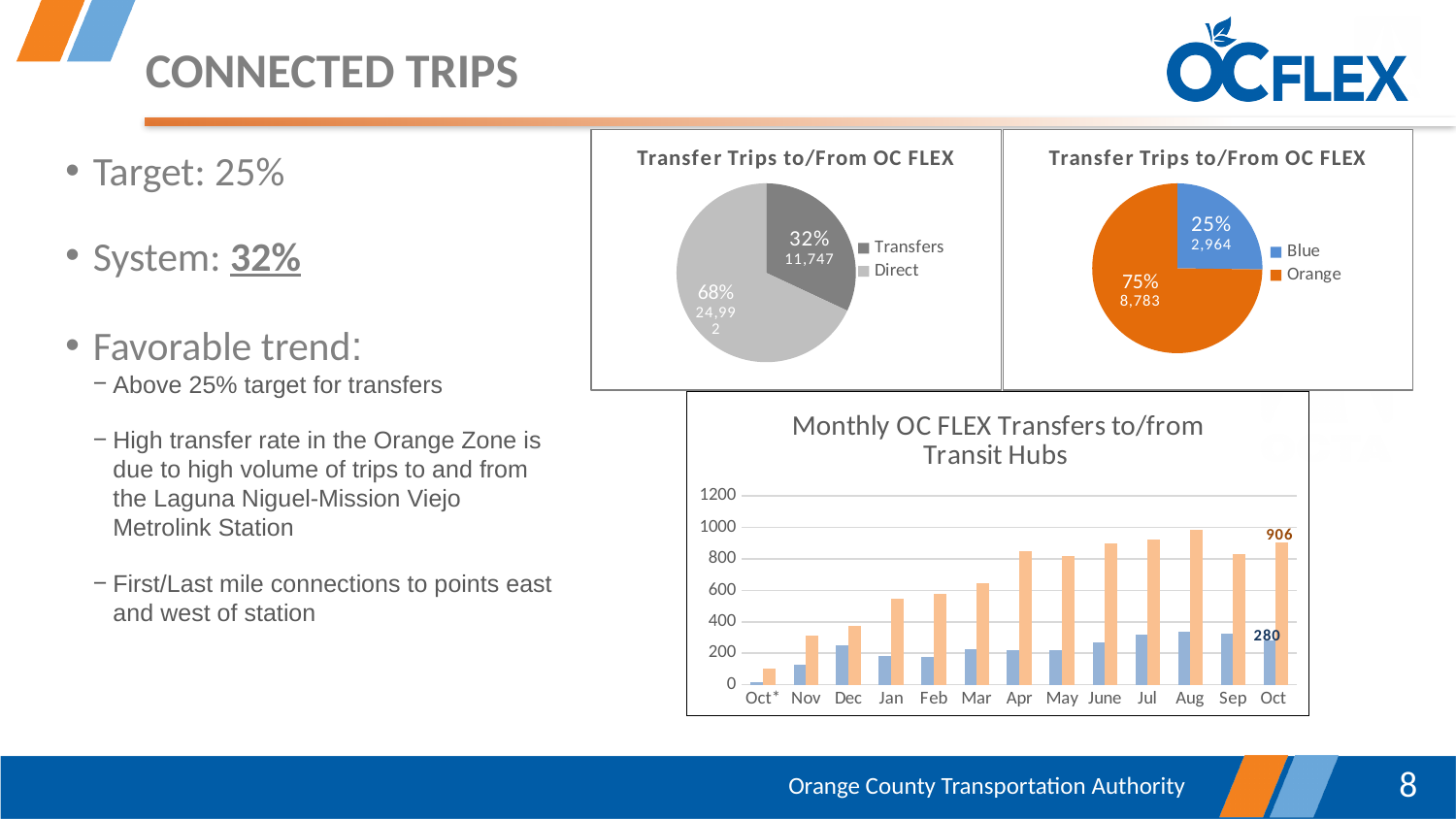
In the chart 'Monthly OC FLEX Transfers to/from Transit Hubs', what is the difference between the two labeled values for Oct (906 and 280)? 626 In the left pie chart titled 'Transfer Trips to/From OC FLEX', which slice is larger, Transfers or Direct? Direct In the chart 'Monthly OC FLEX Transfers to/from Transit Hubs', what is the labeled value of the orange bar for Oct? 906 In the left pie chart titled 'Transfer Trips to/From OC FLEX', what is the value shown for Transfers? 11,747 In the chart 'Monthly OC FLEX Transfers to/from Transit Hubs', how many months are shown on the x axis? 13 In the chart 'Monthly OC FLEX Transfers to/from Transit Hubs', is the orange bar for Nov greater or less than 400? less In the right pie chart titled 'Transfer Trips to/From OC FLEX', what is the value shown for Blue? 2,964 In the left pie chart titled 'Transfer Trips to/From OC FLEX', what share of trips are Transfers? 32% In the right pie chart titled 'Transfer Trips to/From OC FLEX', what is the value shown for Orange? 8,783 In the right pie chart titled 'Transfer Trips to/From OC FLEX', what share does the Orange slice represent? 75% What kind of chart is 'Monthly OC FLEX Transfers to/from Transit Hubs'? Bar chart In the right pie chart titled 'Transfer Trips to/From OC FLEX', how many entries does the legend list? 2